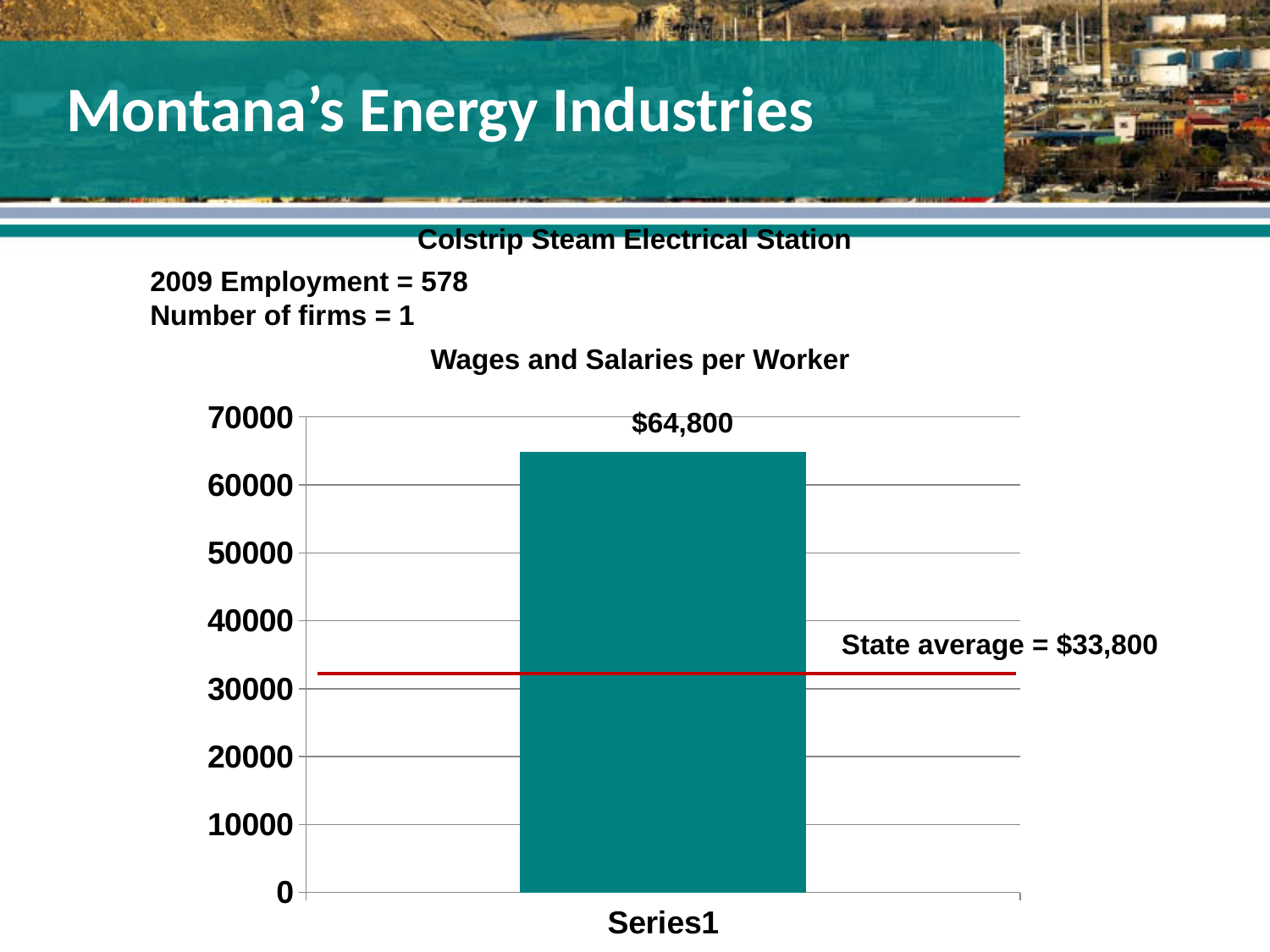
What kind of chart is shown on the slide? Bar chart What is the title of the chart? Wages and Salaries per Worker What is the state average shown on the chart? $33,800 Is the value of the bar greater or less than 60000? greater Which is larger: the plotted bar value or the state average? The plotted bar value How many bars are plotted in the chart? 1 By how much does the plotted wage value exceed the state average? $31,000 What is the value shown on the bar in the Wages and Salaries per Worker chart? $64,800 What is the highest value shown on the y axis? 70000 Is the state average line greater or less than 40000? less What label appears under the bar on the x axis? Series1